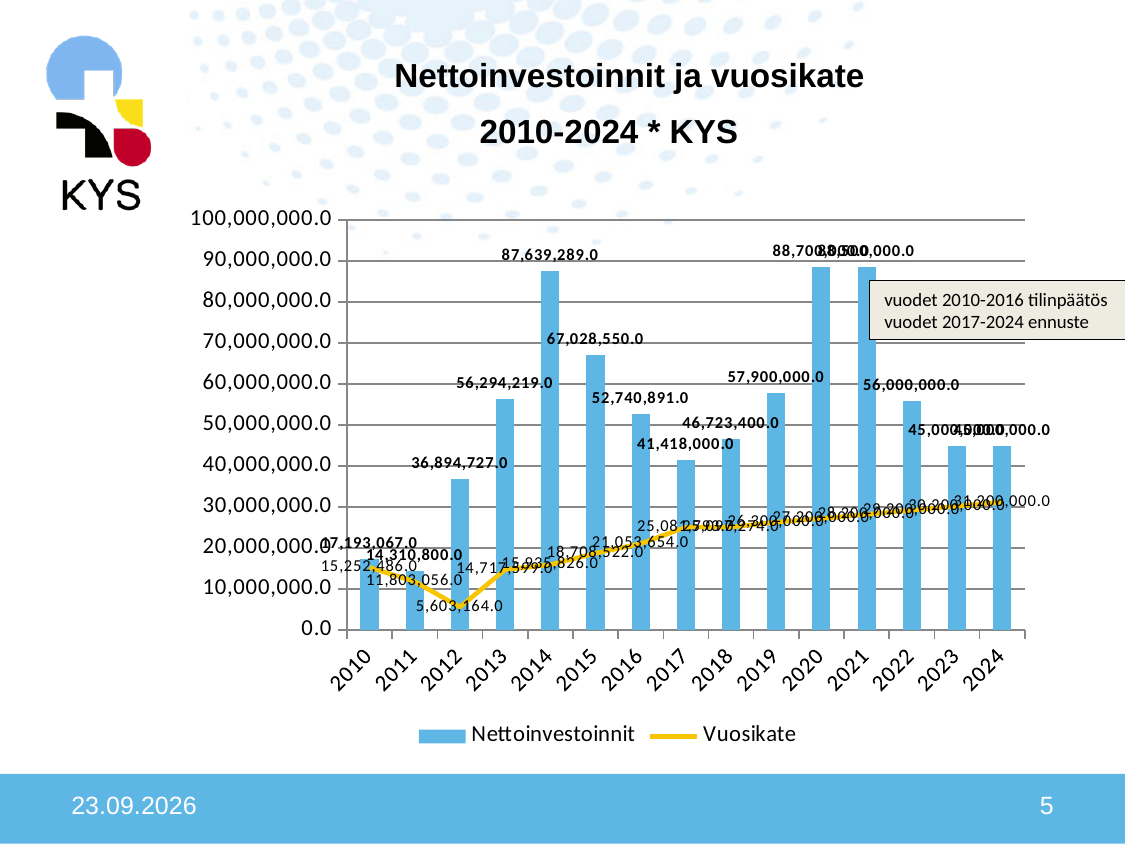
What is the Nettoinvestoinnit value for 2014? 87,639,289.0 Which year has the lowest Vuosikate value? 2012 How many years are shown on the x axis? 15 Which year has the lowest Nettoinvestoinnit value? 2011 Does the Vuosikate line rise or fall from 2012 to 2024? rise What is the Nettoinvestoinnit value for 2017? 41,418,000.0 Which is larger, the Nettoinvestoinnit value for 2015 or for 2016? 2015 What is the Vuosikate value for 2012? 5,603,164.0 What is the difference between the Nettoinvestoinnit values for 2014 and 2015? 20,610,739.0 How many series does the legend list? 2 What is the Vuosikate value for 2016? 21,053,654.0 Is the Nettoinvestoinnit value for 2020 greater or less than 80,000,000.0? greater